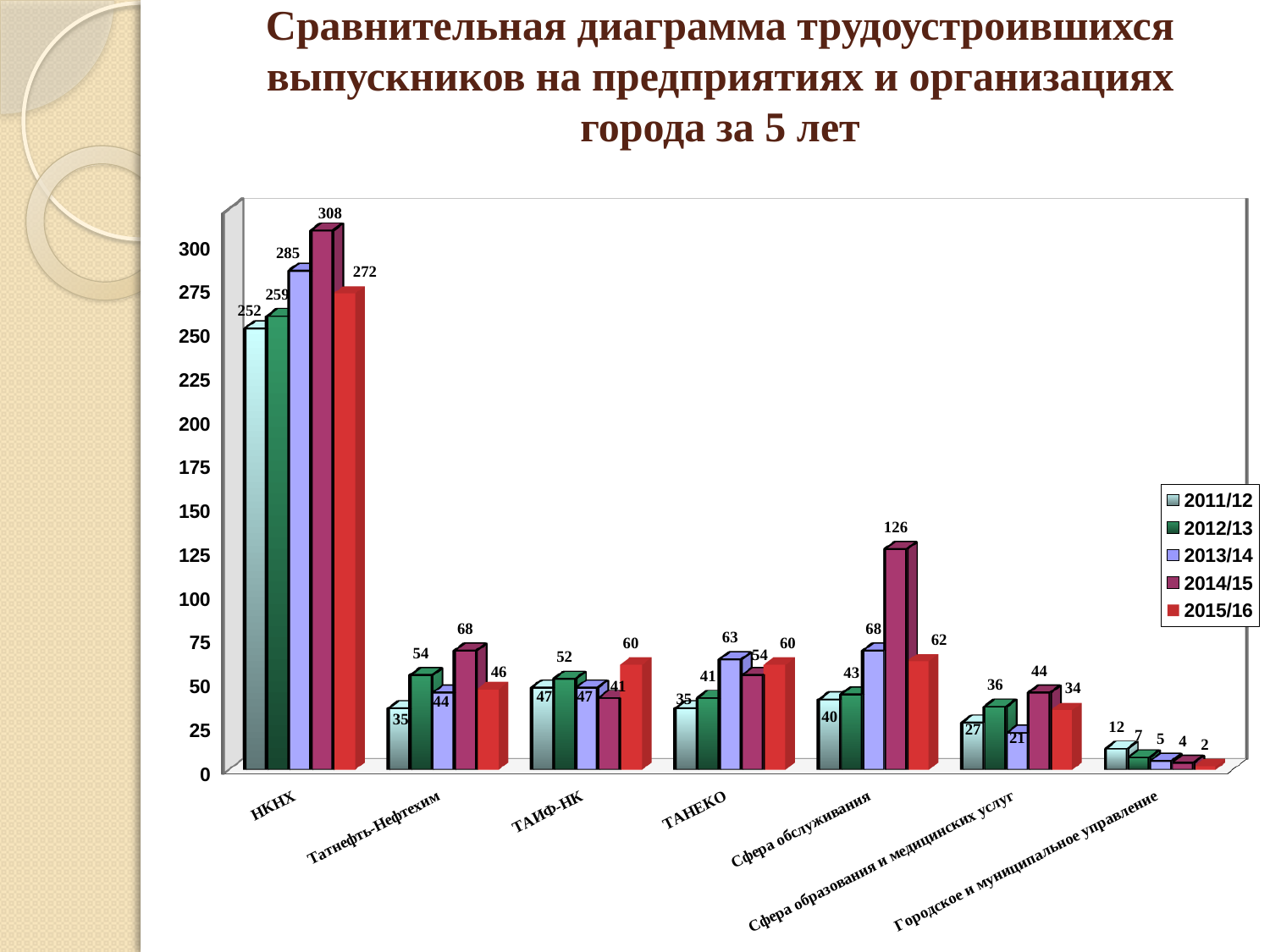
What is the value for Сфера обслуживания in the 2014/15 series? 126 What is the value for ТАНЕКО in the 2013/14 series? 63 What is the difference between the 2014/15 and 2011/12 values for НКНХ? 56 What is the value for НКНХ in the 2014/15 series? 308 Which category has the highest value in the 2015/16 series? НКНХ How many categories are shown on the x axis? 7 Which category has the lowest value in the 2011/12 series? Городское и муниципальное управление Which is larger for Татнефть-Нефтехим: the 2012/13 value or the 2015/16 value? 2012/13 What kind of chart is shown on the slide? bar chart Do the values for Городское и муниципальное управление rise or fall from 2011/12 to 2015/16? fall Which series is shown in red in the legend? 2015/16 How many series does the legend list? 5